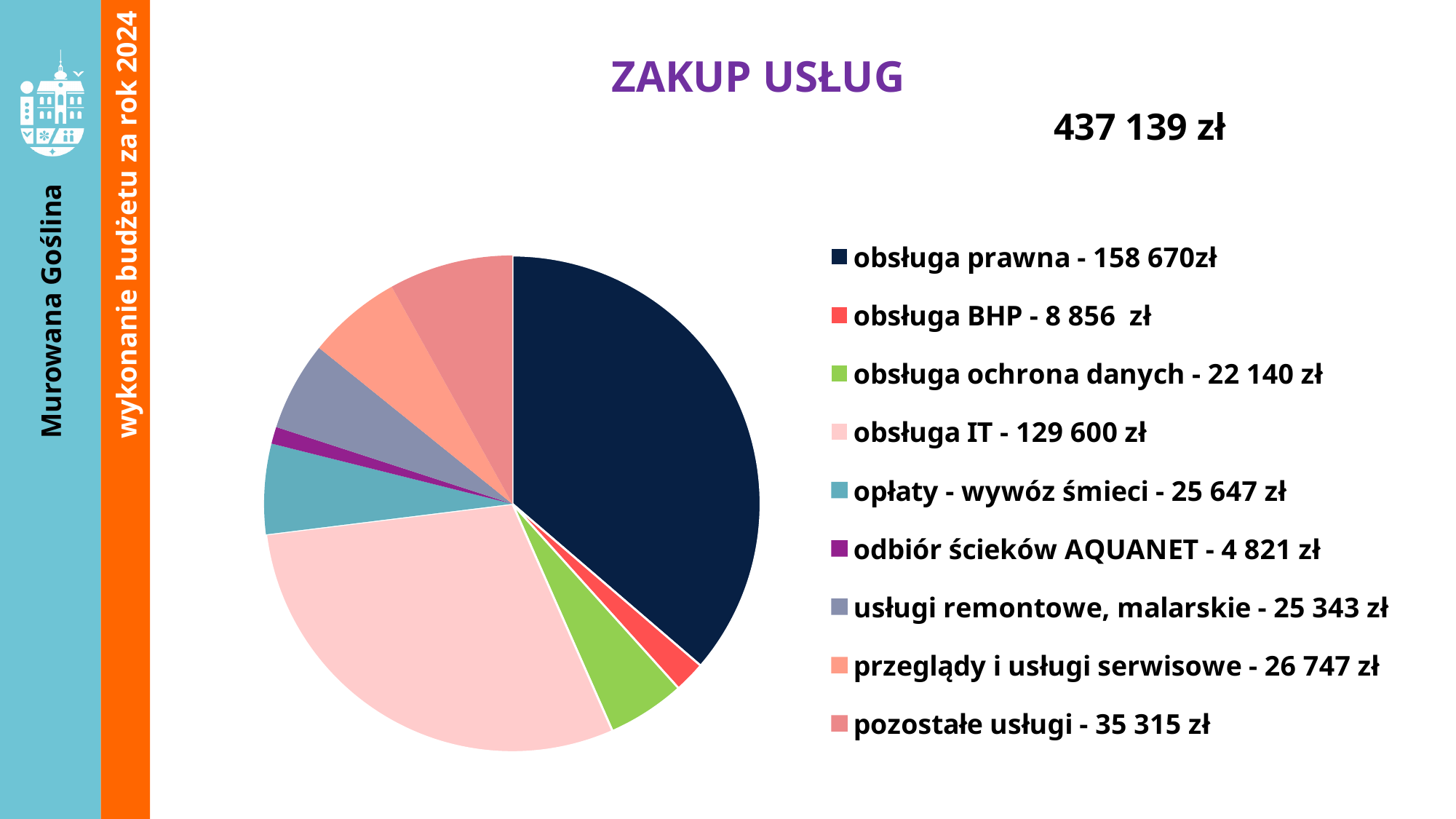
What is the value for przeglądy i usługi serwisowe? 26 747 zł What is the value for obsługa IT? 129 600 zł What kind of chart is shown on the slide? pie chart How many categories does the pie chart have? 9 What is the difference between obsługa prawna and obsługa IT? 29 070 zł What is the value for odbiór ścieków AQUANET? 4 821 zł Which is larger, pozostałe usługi or obsługa BHP? pozostałe usługi What is the title of the chart? ZAKUP USŁUG What is the value for obsługa prawna? 158 670zł What is the total amount shown for ZAKUP USŁUG? 437 139 zł Which category has the largest slice of the pie? obsługa prawna Which category has the smallest slice of the pie? odbiór ścieków AQUANET